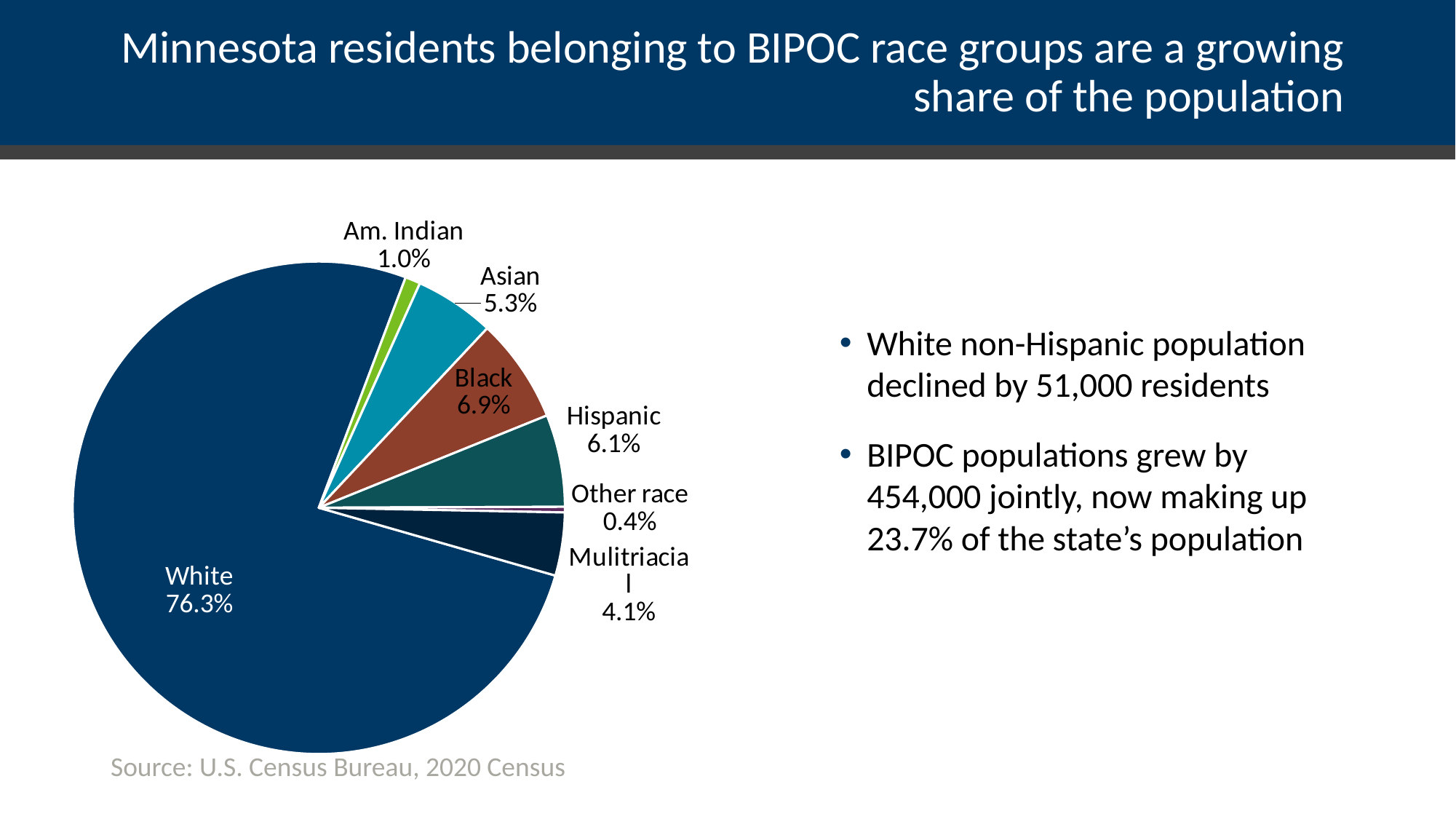
Which category has the largest slice of the pie? White What share of the pie does the White slice represent? 76.3% How many slices does the pie chart have? 7 What is the value for Hispanic? 6.1% Which is larger, the Asian share or the Multiracial share? Asian What is the difference between the Black and Hispanic shares? 0.8% What source is cited below the chart? U.S. Census Bureau, 2020 Census What kind of chart is shown on the slide? Pie chart What is the value shown for the Black slice? 6.9% Which category has the smallest slice of the pie? Other race What is the difference between the Am. Indian and Other race shares? 0.6% What percentage is shown for Asian? 5.3%